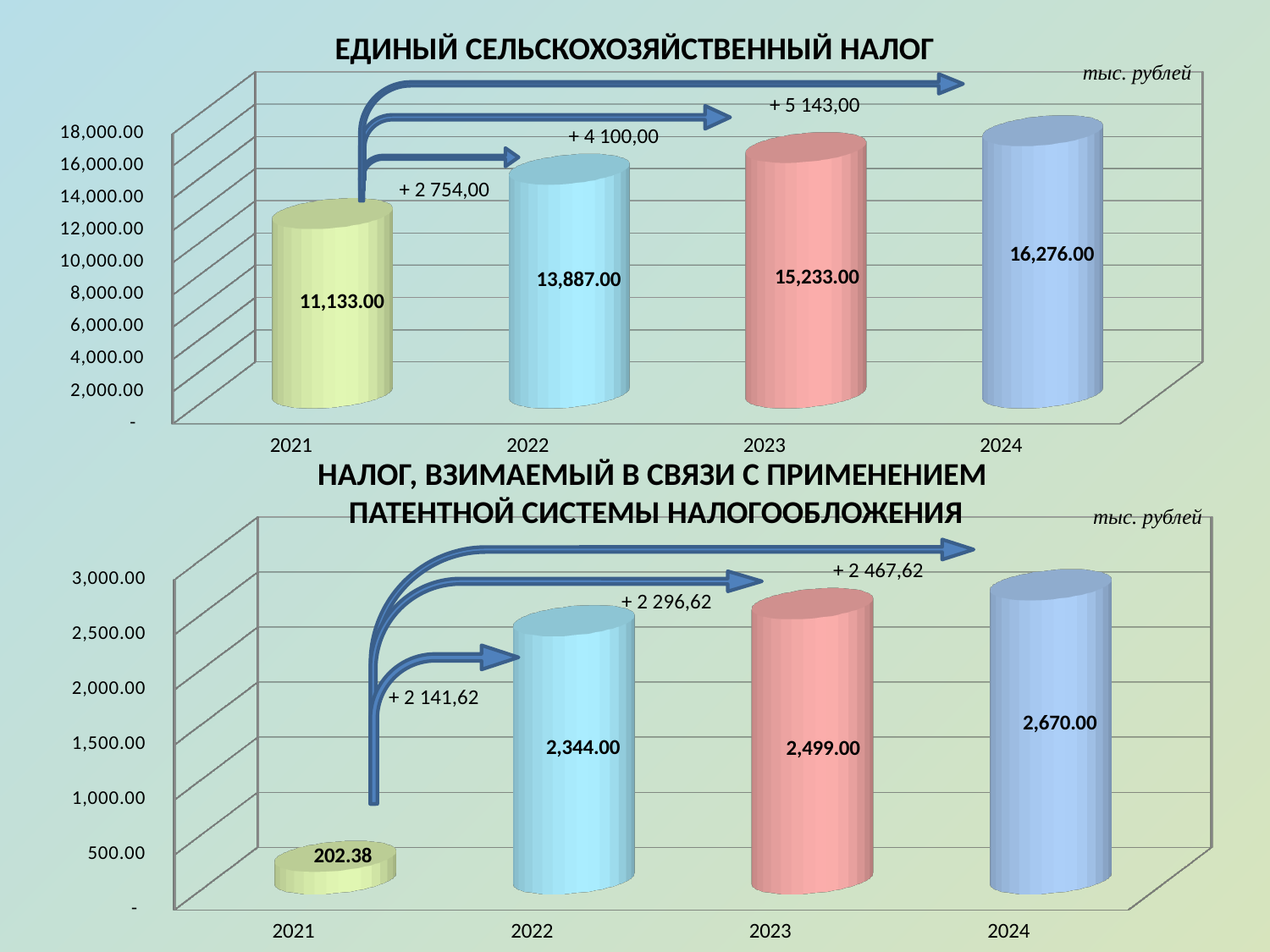
In the top chart (ЕДИНЫЙ СЕЛЬСКОХОЗЯЙСТВЕННЫЙ НАЛОГ), what is the value for 2021? 11,133.00 In the bottom chart (НАЛОГ, ВЗИМАЕМЫЙ В СВЯЗИ С ПРИМЕНЕНИЕМ ПАТЕНТНОЙ СИСТЕМЫ НАЛОГООБЛОЖЕНИЯ), which is larger, the value for 2022 or the value for 2023? 2023 In the bottom chart (НАЛОГ, ВЗИМАЕМЫЙ В СВЯЗИ С ПРИМЕНЕНИЕМ ПАТЕНТНОЙ СИСТЕМЫ НАЛОГООБЛОЖЕНИЯ), what is the difference between the 2024 and 2022 values? 326.00 In the bottom chart (НАЛОГ, ВЗИМАЕМЫЙ В СВЯЗИ С ПРИМЕНЕНИЕМ ПАТЕНТНОЙ СИСТЕМЫ НАЛОГООБЛОЖЕНИЯ), which year has the highest value? 2024 In the top chart (ЕДИНЫЙ СЕЛЬСКОХОЗЯЙСТВЕННЫЙ НАЛОГ), what is the value for 2024? 16,276.00 In the top chart (ЕДИНЫЙ СЕЛЬСКОХОЗЯЙСТВЕННЫЙ НАЛОГ), which year has the lowest value? 2021 In the top chart (ЕДИНЫЙ СЕЛЬСКОХОЗЯЙСТВЕННЫЙ НАЛОГ), how many years are shown? 4 In the bottom chart (НАЛОГ, ВЗИМАЕМЫЙ В СВЯЗИ С ПРИМЕНЕНИЕМ ПАТЕНТНОЙ СИСТЕМЫ НАЛОГООБЛОЖЕНИЯ), what is the value for 2023? 2,499.00 In the top chart (ЕДИНЫЙ СЕЛЬСКОХОЗЯЙСТВЕННЫЙ НАЛОГ), what is the difference between the 2023 and 2022 values? 1,346.00 What kind of chart is the top chart (ЕДИНЫЙ СЕЛЬСКОХОЗЯЙСТВЕННЫЙ НАЛОГ)? bar chart In the top chart (ЕДИНЫЙ СЕЛЬСКОХОЗЯЙСТВЕННЫЙ НАЛОГ), do the values rise or fall from 2021 to 2024? rise In the bottom chart (НАЛОГ, ВЗИМАЕМЫЙ В СВЯЗИ С ПРИМЕНЕНИЕМ ПАТЕНТНОЙ СИСТЕМЫ НАЛОГООБЛОЖЕНИЯ), what is the value for 2021? 202.38